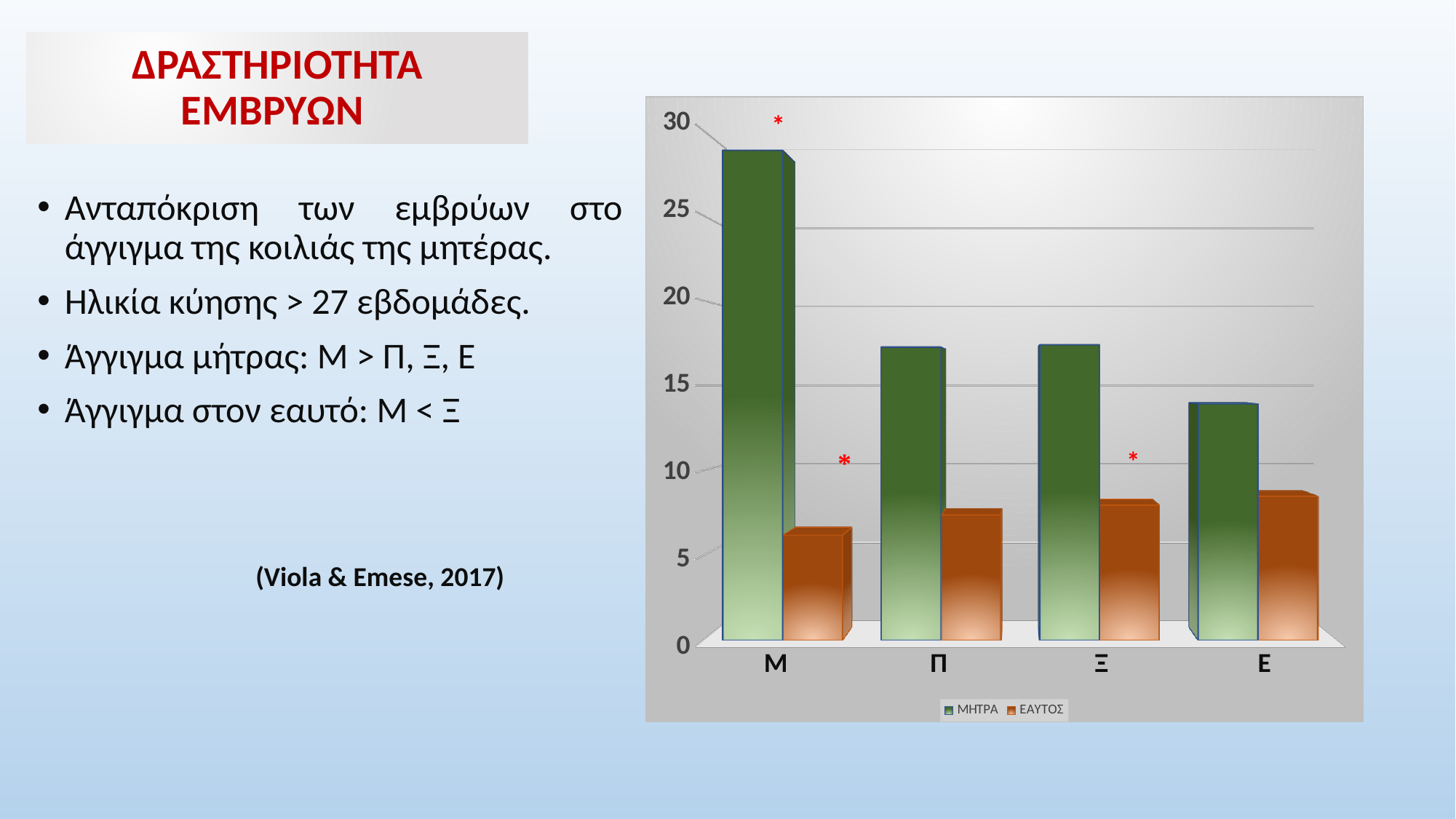
Is the ΕΑΥΤΟΣ value for Ξ greater or less than 10? less Is the ΜΗΤΡΑ value for Μ greater or less than 25? greater What kind of chart is shown on the slide? bar chart Is the ΜΗΤΡΑ value for Ε greater or less than 15? less What colour are the bars for the ΕΑΥΤΟΣ series? orange Which category has the lowest value for the ΕΑΥΤΟΣ series? Μ For category Μ, which series has the larger value, ΜΗΤΡΑ or ΕΑΥΤΟΣ? ΜΗΤΡΑ How many series does the chart legend list? 2 How many categories are shown on the x axis of the chart? 4 Which category has the lowest value for the ΜΗΤΡΑ series? Ε Which series is larger for category Π, ΜΗΤΡΑ or ΕΑΥΤΟΣ? ΜΗΤΡΑ Which category has the highest value for the ΜΗΤΡΑ series? Μ